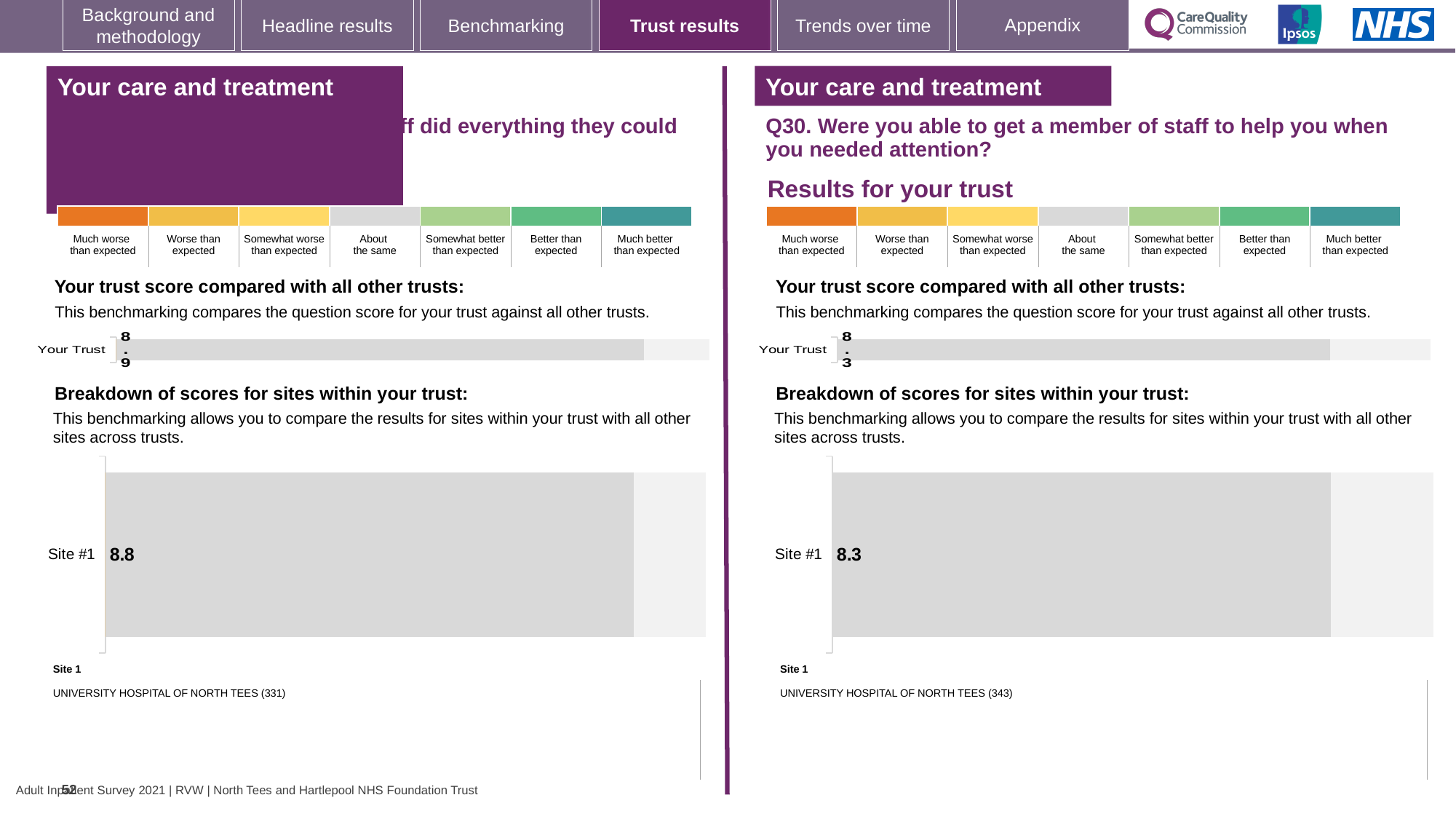
On the left panel, what is the score shown for Site #1 in the 'Breakdown of scores for sites within your trust' chart? 8.8 On the left panel, what is the score shown for Your Trust in the 'Your trust score compared with all other trusts' chart? 8.9 What is the difference between the Site #1 score on the left panel (8.8) and the Site #1 score on the right panel (8.3)? 0.5 On the right panel (Q30), what is the score shown for Your Trust in the 'Your trust score compared with all other trusts' chart? 8.3 How many sites are shown in the 'Breakdown of scores for sites within your trust' chart on the left panel? 1 How many sites are shown in the 'Breakdown of scores for sites within your trust' chart on the right panel (Q30)? 1 Which site name is listed as Site 1 below the chart on the left panel? UNIVERSITY HOSPITAL OF NORTH TEES (331) What kind of chart is used to show the Site #1 score on the right panel (Q30)? bar chart Which site name is listed as Site 1 below the chart on the right panel (Q30)? UNIVERSITY HOSPITAL OF NORTH TEES (343) What is the difference between the Your Trust score on the left panel (8.9) and the Your Trust score on the right panel (8.3)? 0.6 On the right panel (Q30), what is the score shown for Site #1 in the 'Breakdown of scores for sites within your trust' chart? 8.3 Which is larger: the Your Trust score on the left panel or the Your Trust score on the right panel (Q30)? Left panel (8.9)